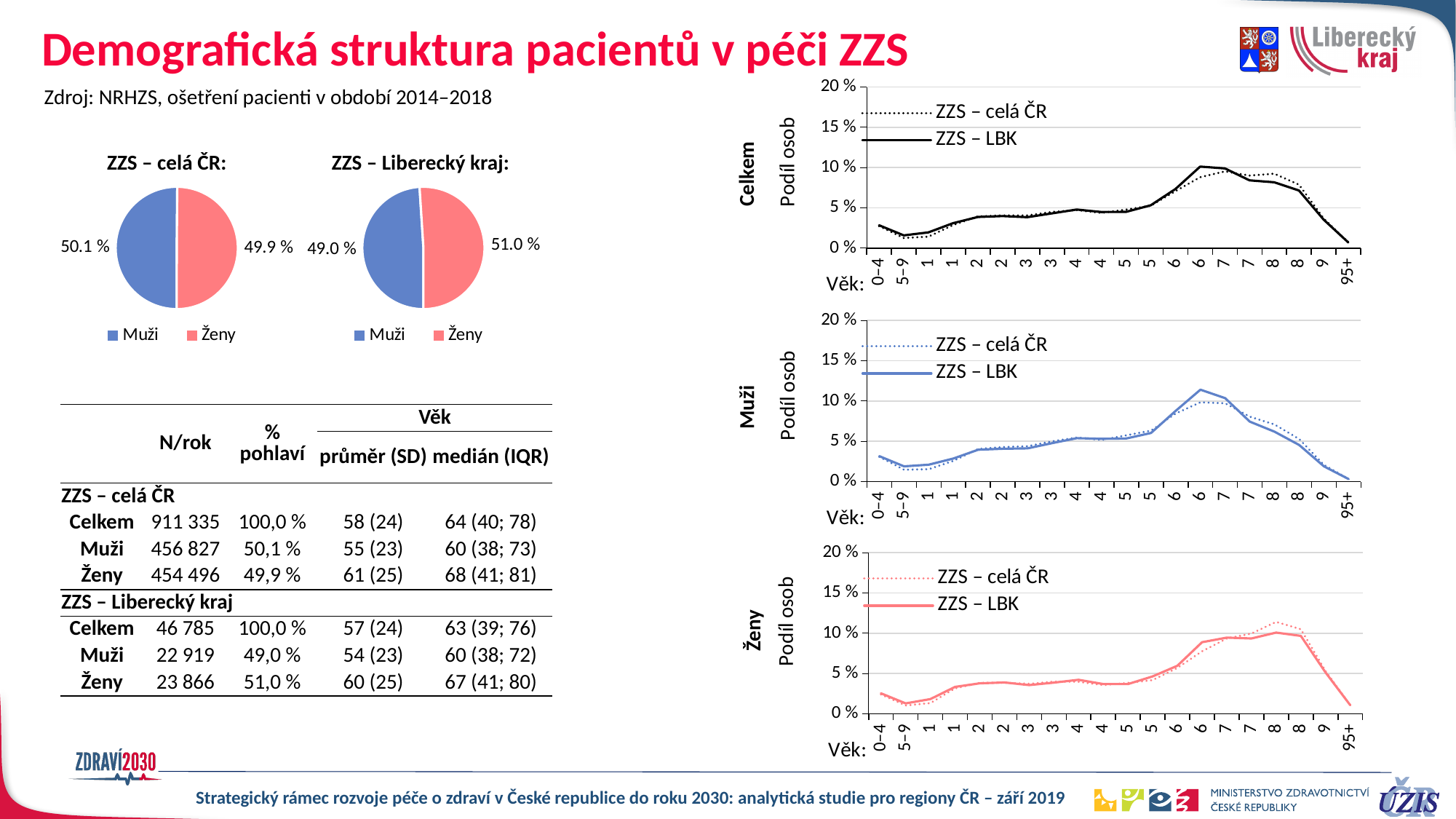
In the "Celkem" line chart, is the value for the 95+ age group for ZZS – LBK greater or less than 5 %? less What kind of chart is the "Muži" chart on the right side of the slide? Line chart How many slices does the pie chart titled "ZZS – Liberecký kraj" have? 2 In the pie chart titled "ZZS – celá ČR", what share is shown for Muži? 50.1 % In the "Muži" line chart, is the peak value of the ZZS – LBK series greater or less than 10 %? greater What kind of chart is used for "ZZS – celá ČR" on the left of the slide? Pie chart In the pie chart titled "ZZS – Liberecký kraj", what share is shown for Muži? 49.0 % In the pie chart titled "ZZS – celá ČR", what share is shown for Ženy? 49.9 % In the pie chart titled "ZZS – Liberecký kraj", what share is shown for Ženy? 51.0 % How many series does the legend of the "Celkem" line chart list? 2 In the pie chart titled "ZZS – celá ČR", what is the difference between the Muži and Ženy shares? 0.2 % In the pie chart titled "ZZS – Liberecký kraj", which slice is larger, Muži or Ženy? Ženy